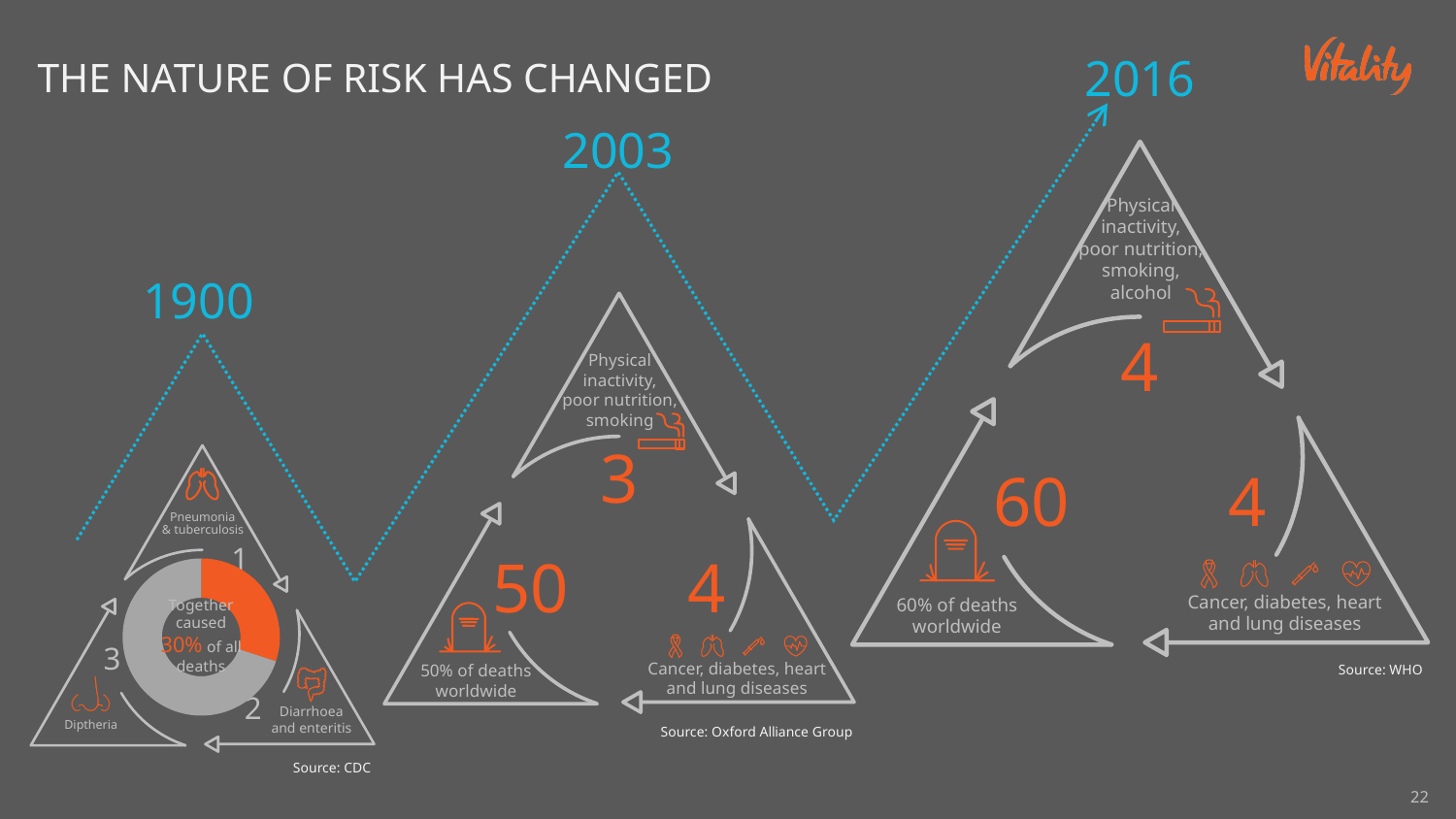
Which year label appears above the donut chart on the slide? 1900 Does the percentage of deaths worldwide shown on the slide rise or fall from 2003 to 2016? Rise According to the 2003 section of the slide, what percentage of deaths worldwide is shown? 50% What is the difference between the 2016 percentage of deaths worldwide (60%) and the 2003 percentage (50%) shown on the slide? 10% According to the 2016 section of the slide, what percentage of deaths worldwide is shown? 60% In the donut chart under 1900, which slice is larger, the orange slice or the grey slice? The grey slice How many slices does the donut chart under 1900 have? 2 In the donut chart under 1900, what share of all deaths does the orange slice represent? 30% What text is printed in the centre of the donut chart under 1900? Together caused 30% of all deaths In the donut chart under 1900, is the orange slice greater or less than 50% of the donut? less What kind of chart is shown inside the 1900 triangle on the slide? Donut (pie) chart